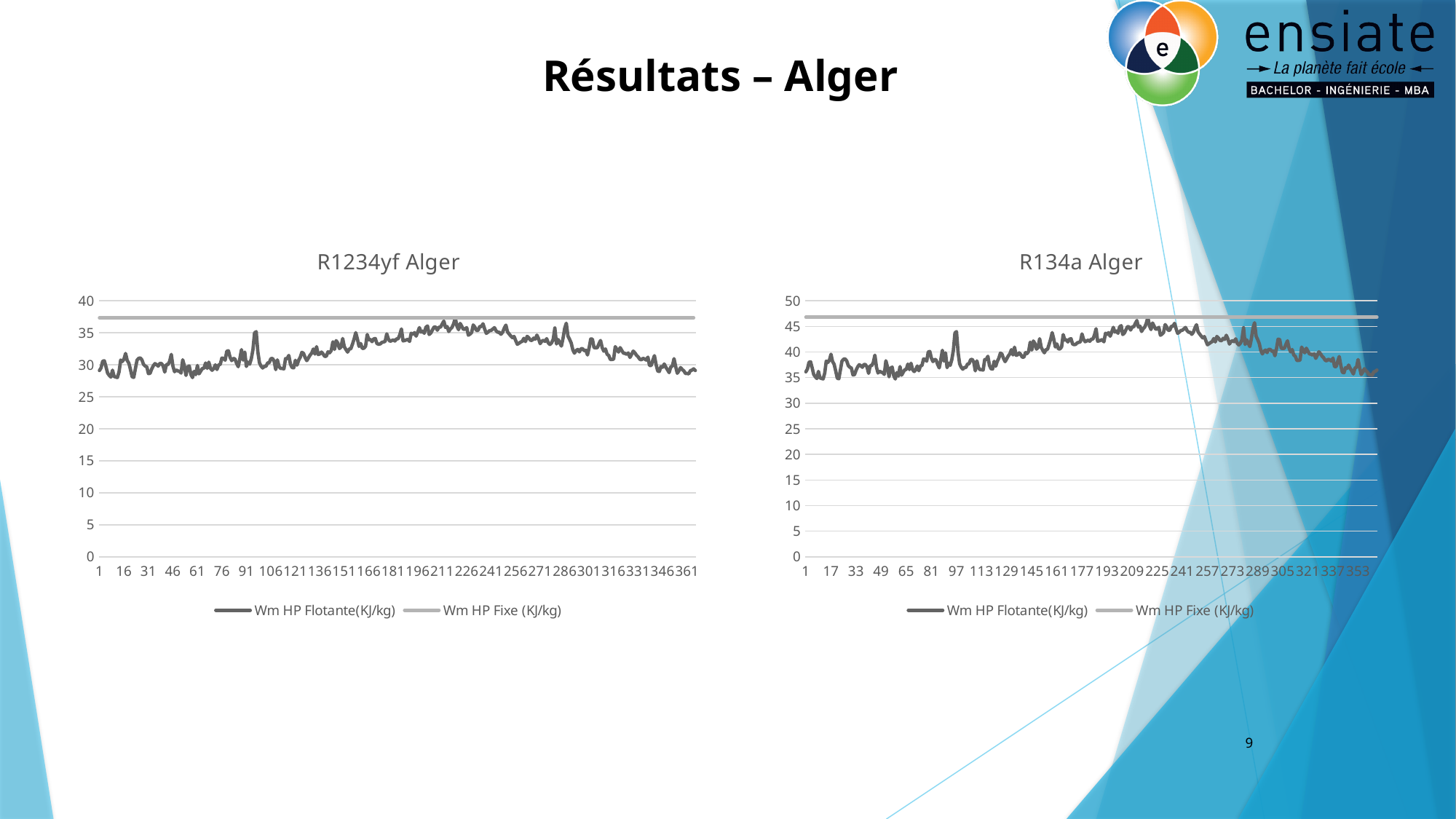
In the R134a Alger chart, is the value of Wm HP Fixe (KJ/kg) greater or less than 45? greater What is the title of the chart on the left of the slide? R1234yf Alger In the R134a Alger chart, is the value of Wm HP Flotante(KJ/kg) at point 1 greater or less than 40? less How many series does the legend of the R1234yf Alger chart list? 2 In the R1234yf Alger chart, is the value of Wm HP Fixe (KJ/kg) greater or less than 35? greater What are the two legend entries of the R134a Alger chart? Wm HP Flotante(KJ/kg) and Wm HP Fixe (KJ/kg) How many series does the legend of the R134a Alger chart list? 2 What type of chart is the R134a Alger chart? line chart In the R1234yf Alger chart, which series has the higher values, Wm HP Flotante(KJ/kg) or Wm HP Fixe (KJ/kg)? Wm HP Fixe (KJ/kg) In the R1234yf Alger chart, does the Wm HP Flotante(KJ/kg) series generally rise or fall between point 1 and point 211? rise What type of chart is the R1234yf Alger chart? line chart